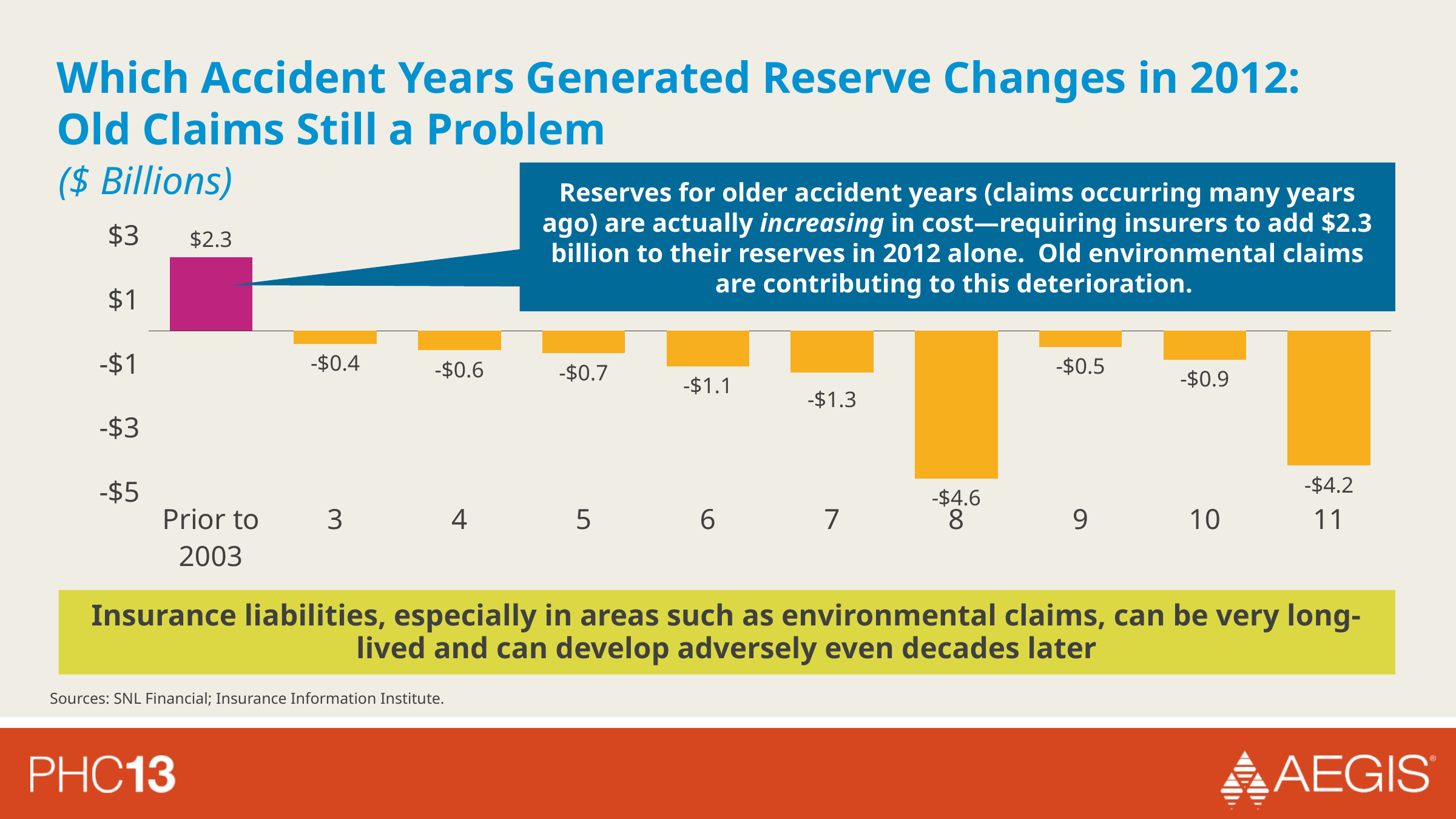
What kind of chart is shown on the slide? bar chart What is the value for accident year 8? -$4.6 Which category has the lowest value? 8 What is the difference between the values for accident year 8 and accident year 11? $0.4 What colour is the bar for 'Prior to 2003'? magenta Which is larger, the value for accident year 6 or accident year 7? 6 How many categories are shown on the x axis? 10 What is the difference between the values for accident year 3 and accident year 7? $0.9 What is the value for accident year 11? -$4.2 Which category has the highest value? Prior to 2003 What is the value for the 'Prior to 2003' category? $2.3 What is the value for accident year 5? -$0.7